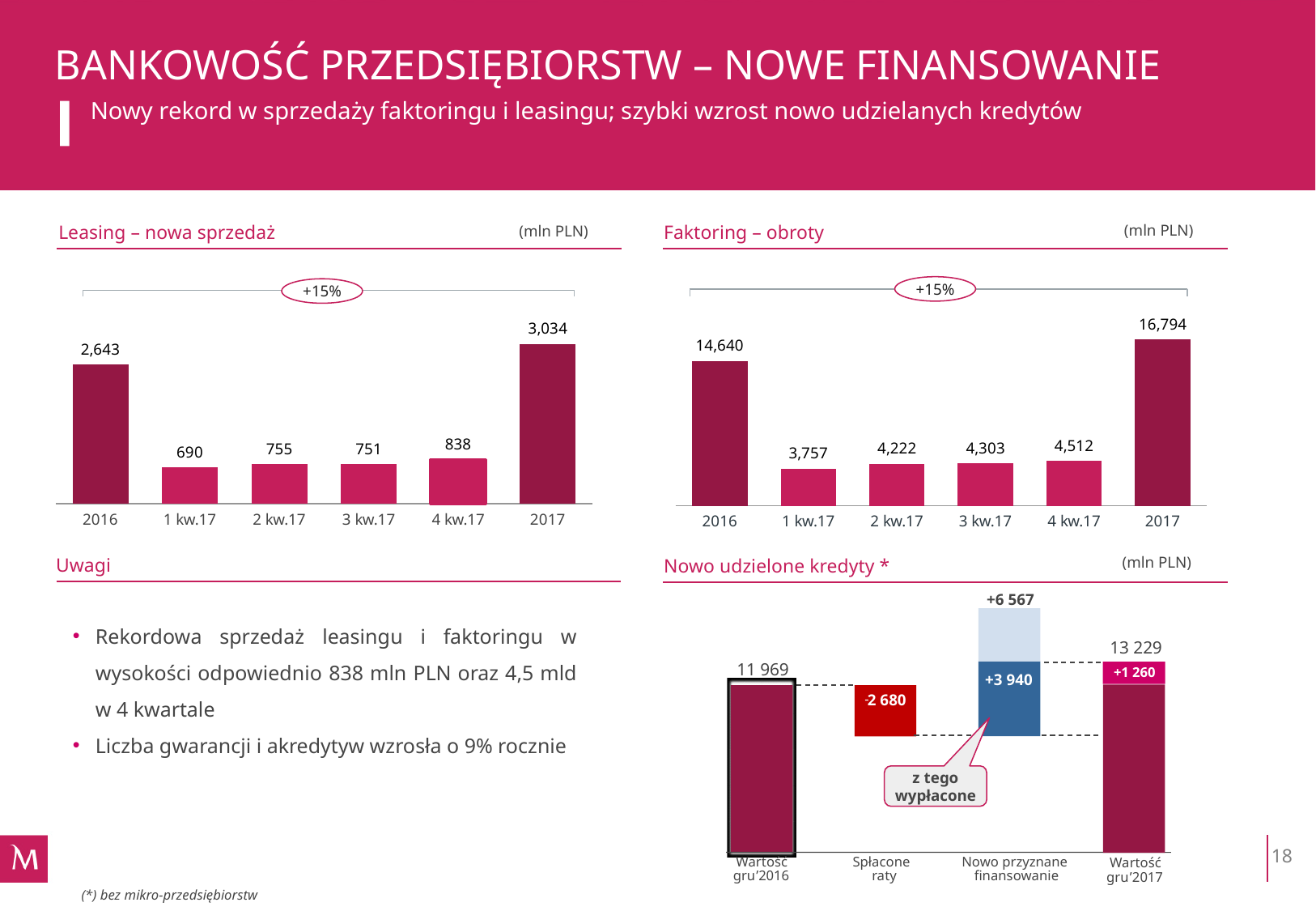
In the 'Faktoring – obroty' chart, which is larger: the value for 1 kw.17 or 4 kw.17? 4 kw.17 In the 'Faktoring – obroty' chart, what is the value for 2017? 16,794 In the 'Faktoring – obroty' chart, do the quarterly values from 1 kw.17 to 4 kw.17 rise or fall? Rise In the 'Leasing – nowa sprzedaż' chart, what is the difference between the 2017 and 2016 values? 391 In the 'Leasing – nowa sprzedaż' chart, what is the value for 4 kw.17? 838 How many categories are shown on the x axis of the 'Leasing – nowa sprzedaż' chart? 6 In the 'Nowo udzielone kredyty *' chart, what is the value shown for 'Spłacone raty'? -2 680 In the 'Faktoring – obroty' chart, which category has the lowest value? 1 kw.17 What kind of chart is 'Faktoring – obroty'? Bar chart In the 'Leasing – nowa sprzedaż' chart, which category has the highest value? 2017 In the 'Faktoring – obroty' chart, what is the difference between the 2017 and 2016 values? 2,154 In the 'Nowo udzielone kredyty *' chart, what is the value for 'Wartość gru'2017'? 13 229